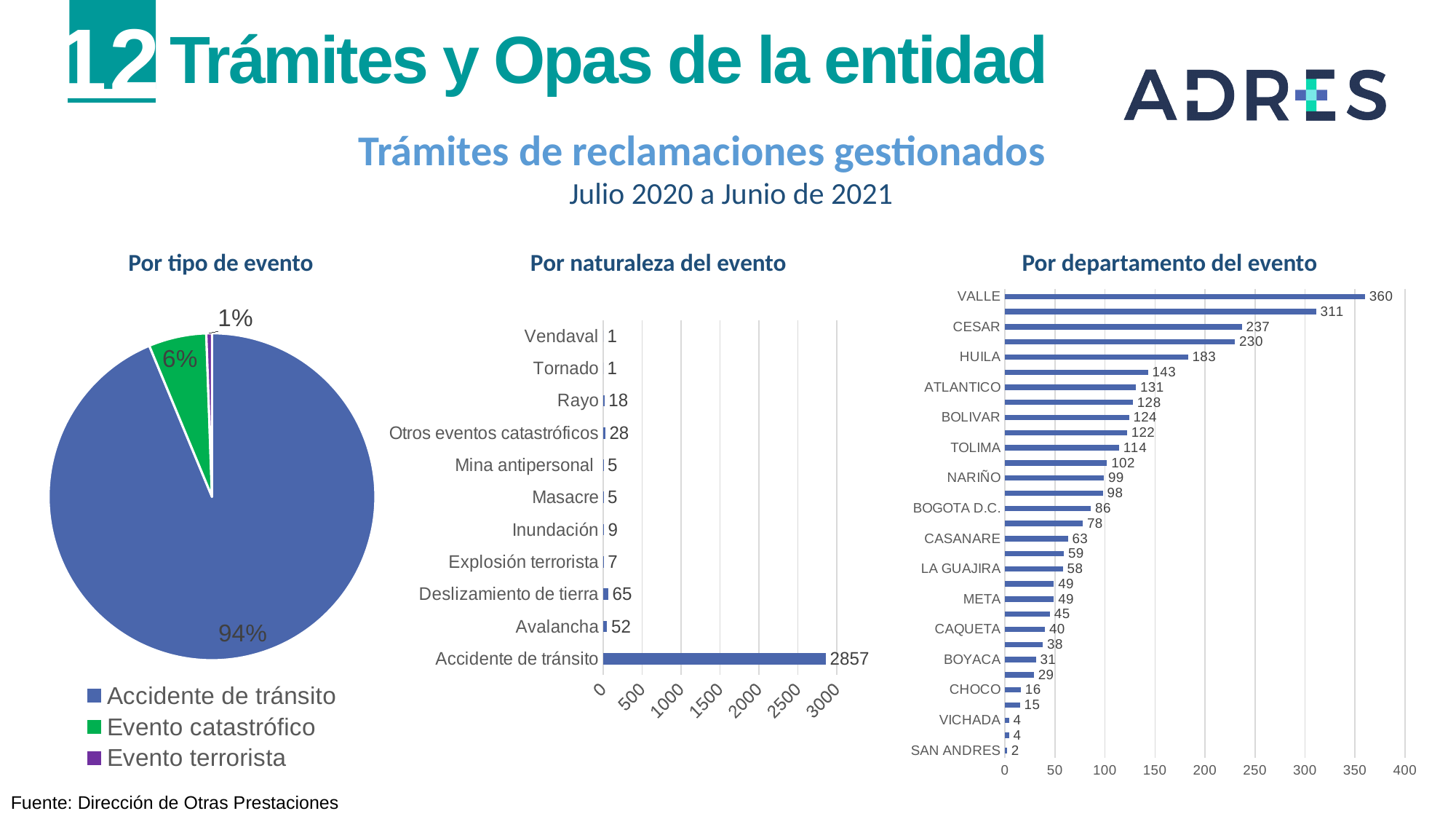
What kind of chart is 'Por naturaleza del evento'? Bar chart In the 'Por naturaleza del evento' chart, what is the value for Accidente de tránsito? 2857 In the 'Por departamento del evento' chart, which department has the highest value? VALLE In the 'Por departamento del evento' chart, what is the difference between VALLE and CESAR? 123 In the 'Por naturaleza del evento' chart, what is the difference between Deslizamiento de tierra and Avalancha? 13 In the 'Por departamento del evento' chart, which is larger, BOLIVAR or TOLIMA? BOLIVAR How many categories are shown in the 'Por naturaleza del evento' chart? 11 How many entries does the legend of the 'Por tipo de evento' pie chart list? 3 In the 'Por departamento del evento' chart, what is the value for HUILA? 183 In the 'Por tipo de evento' pie chart, what share is Evento catastrófico? 6% In the 'Por naturaleza del evento' chart, what is the value for Deslizamiento de tierra? 65 In the 'Por tipo de evento' pie chart, what share is Accidente de tránsito? 94%